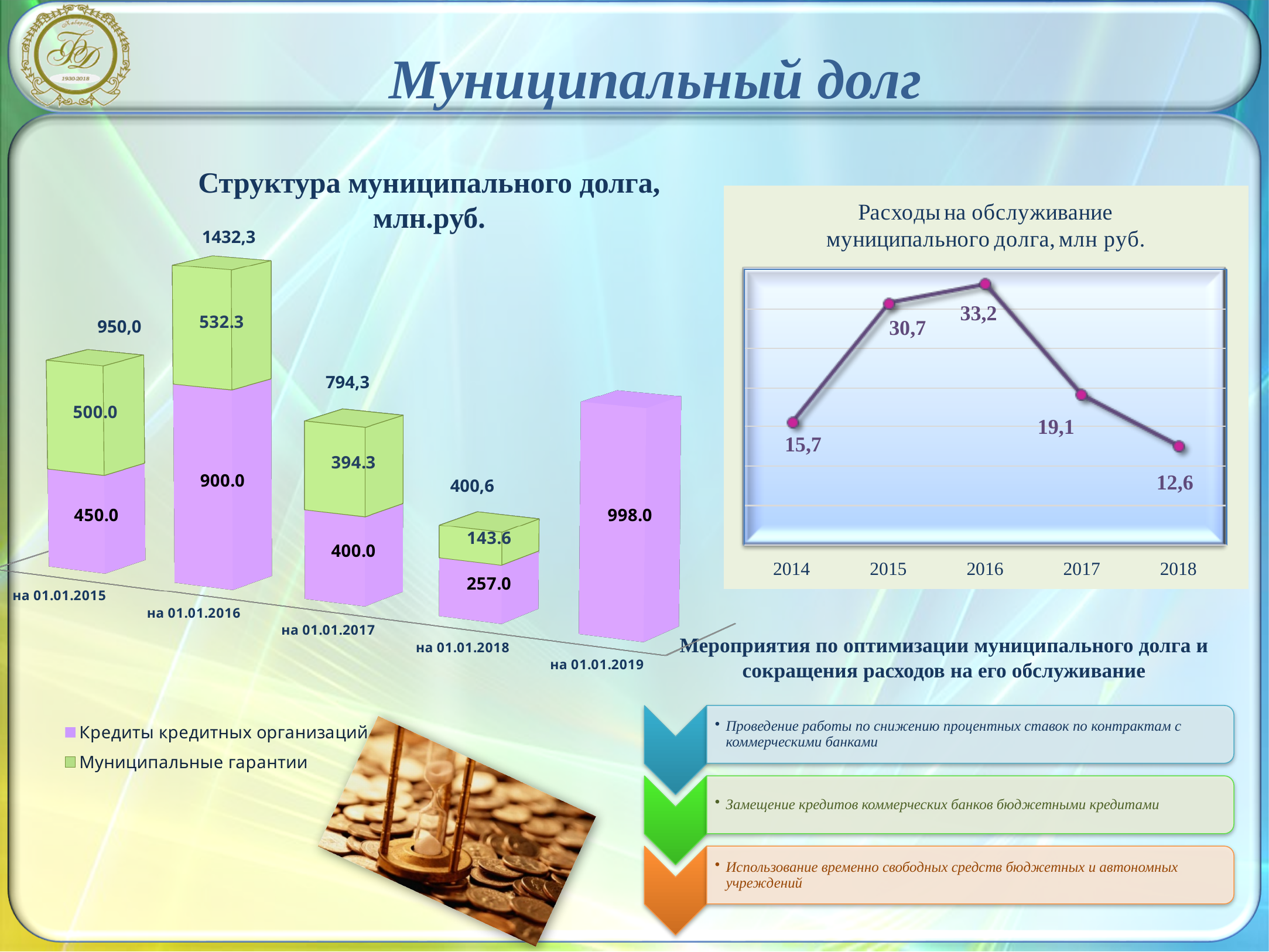
How many series does the legend of the chart 'Структура муниципального долга, млн.руб.' list? 2 In the chart 'Структура муниципального долга, млн.руб.', what is the value of 'Кредиты кредитных организаций' for 'на 01.01.2016'? 900.0 In the chart 'Структура муниципального долга, млн.руб.', which date has the lowest total municipal debt? на 01.01.2018 In the chart 'Расходы на обслуживание муниципального долга, млн руб.', do the values rise or fall from 2016 to 2018? Fall What kind of chart is 'Расходы на обслуживание муниципального долга, млн руб.'? Line chart In the chart 'Структура муниципального долга, млн.руб.', what is the total of the stacked bar for 'на 01.01.2017'? 794,3 In the chart 'Структура муниципального долга, млн.руб.', what is the difference between 'Кредиты кредитных организаций' and 'Муниципальные гарантии' for 'на 01.01.2015'? 50.0 In the chart 'Расходы на обслуживание муниципального долга, млн руб.', which year has the lowest value? 2018 In the chart 'Расходы на обслуживание муниципального долга, млн руб.', what is the difference between the values for 2015 and 2017? 11,6 In the chart 'Расходы на обслуживание муниципального долга, млн руб.', what is the value for 2016? 33,2 In the chart 'Структура муниципального долга, млн.руб.', what is the value of 'Муниципальные гарантии' for 'на 01.01.2018'? 143.6 In the chart 'Структура муниципального долга, млн.руб.', which date has the highest total municipal debt? на 01.01.2016